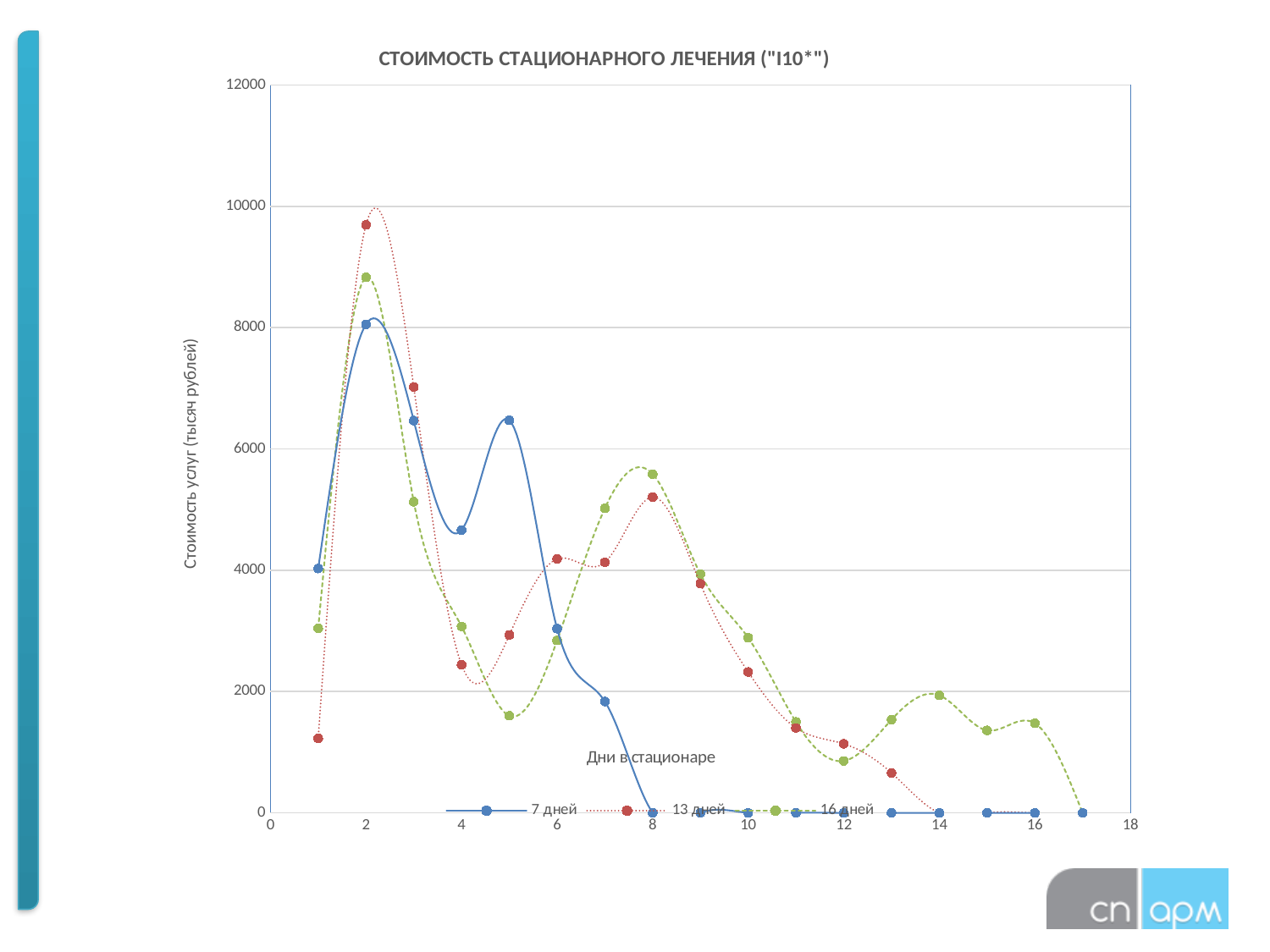
What is the title of the chart? СТОИМОСТЬ СТАЦИОНАРНОГО ЛЕЧЕНИЯ ("I10*") What kind of chart is shown on the slide? line chart At day 2, which series has the higher value, "13 дней" or "7 дней"? 13 дней At day 5, which series has the higher value, "7 дней" or "16 дней"? 7 дней How many series does the legend list? 3 Is the value for the "13 дней" series at day 2 greater or less than 8000? greater Does the "7 дней" series rise or fall between day 5 and day 8? fall Is the value for the "16 дней" series at day 14 greater or less than 4000? less Is the value for the "16 дней" series at day 1 greater or less than 2000? greater What is the label of the vertical axis? Стоимость услуг (тысяч рублей) Which series reaches the highest peak value on the chart? 13 дней